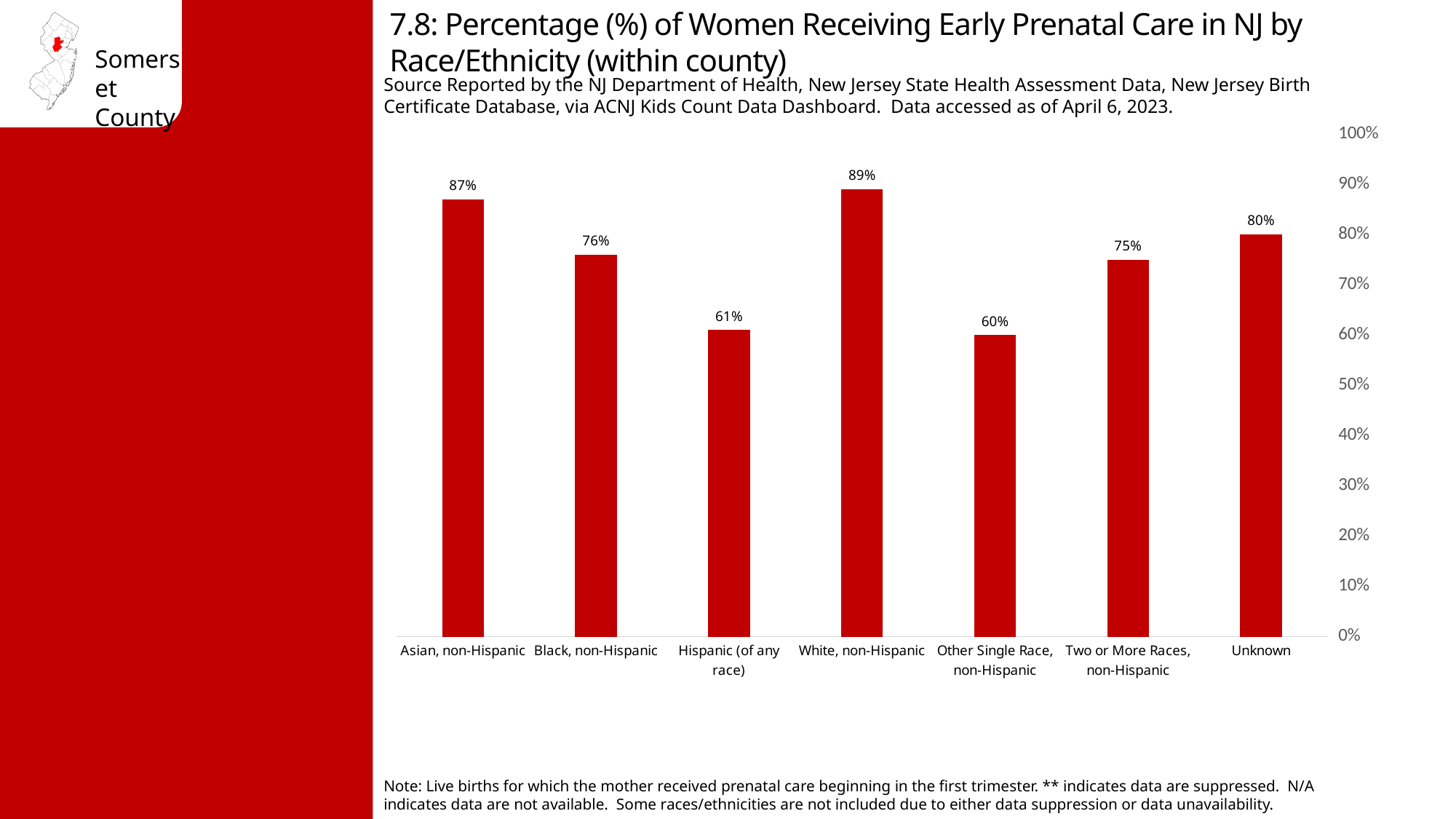
What kind of chart is shown on the slide? Bar chart What percentage of Asian, non-Hispanic women received early prenatal care? 87% What is the value shown for Hispanic (of any race)? 61% Which category has the lowest percentage? Other Single Race, non-Hispanic What colour are the bars in the chart? Red Which race/ethnicity category has the highest percentage of women receiving early prenatal care? White, non-Hispanic How many race/ethnicity categories are shown on the chart? 7 What percentage is shown for the Unknown category? 80% Is the value for Black, non-Hispanic greater or less than 70%? greater Which is larger, the value for Two or More Races, non-Hispanic or the value for Unknown? Unknown What is the difference between the values for Asian, non-Hispanic and Hispanic (of any race)? 26% What is the difference between the percentages for White, non-Hispanic and Black, non-Hispanic? 13%